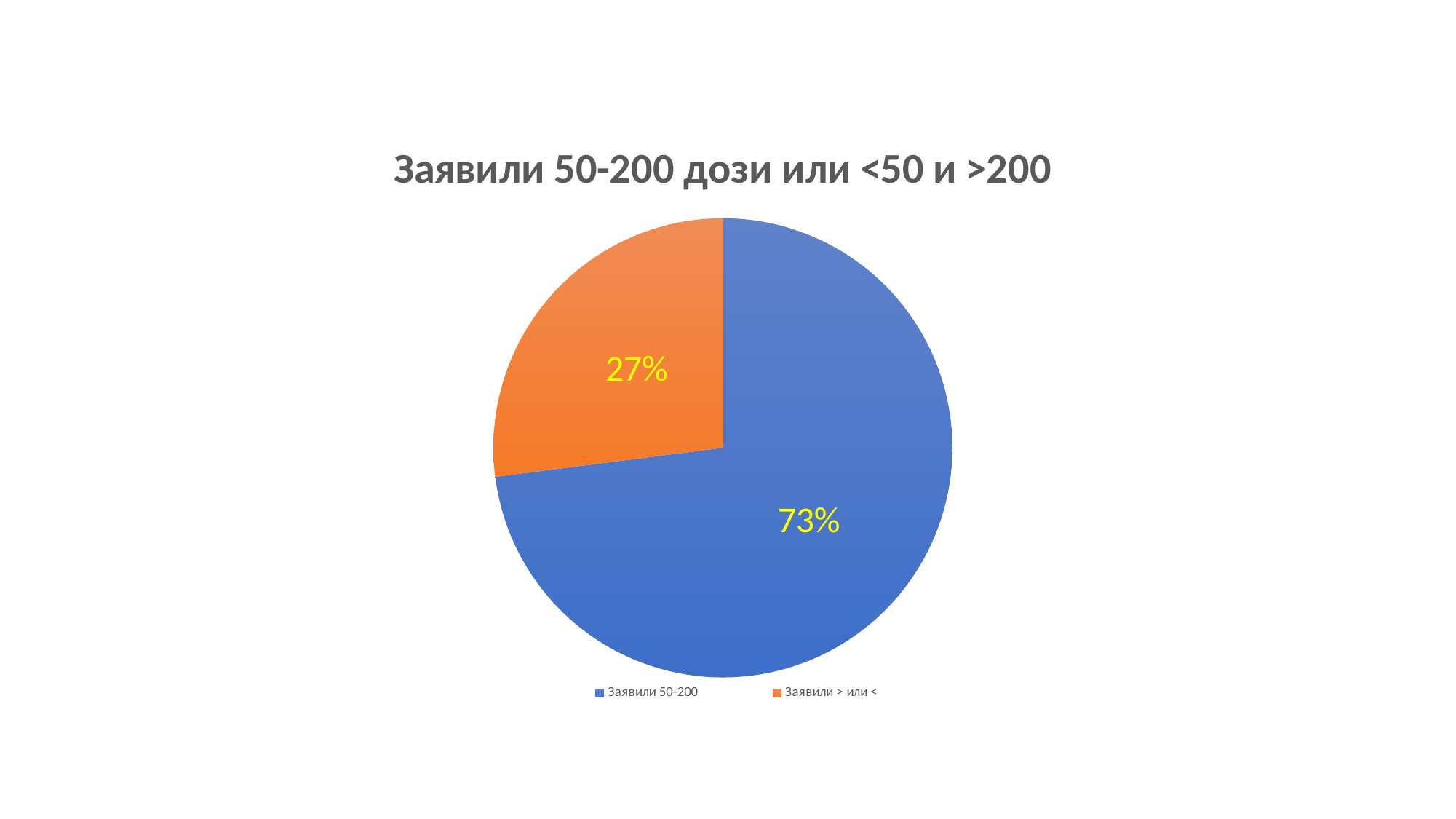
Which slice is the smallest? Заявили > или < What is the difference in percentage points between the "Заявили 50-200" slice and the "Заявили > или <" slice? 46 How many entries does the legend list? 2 Which is larger: the "Заявили 50-200" slice or the "Заявили > или <" slice? Заявили 50-200 What kind of chart is shown on the slide? pie chart What share of the pie does "Заявили > или <" take? 27% How many slices does the pie chart have? 2 Which slice is the largest? Заявили 50-200 What share of the pie does "Заявили 50-200" take? 73% What is the title of the chart? Заявили 50-200 дози или <50 и >200 What colour is the "Заявили > или <" slice? orange